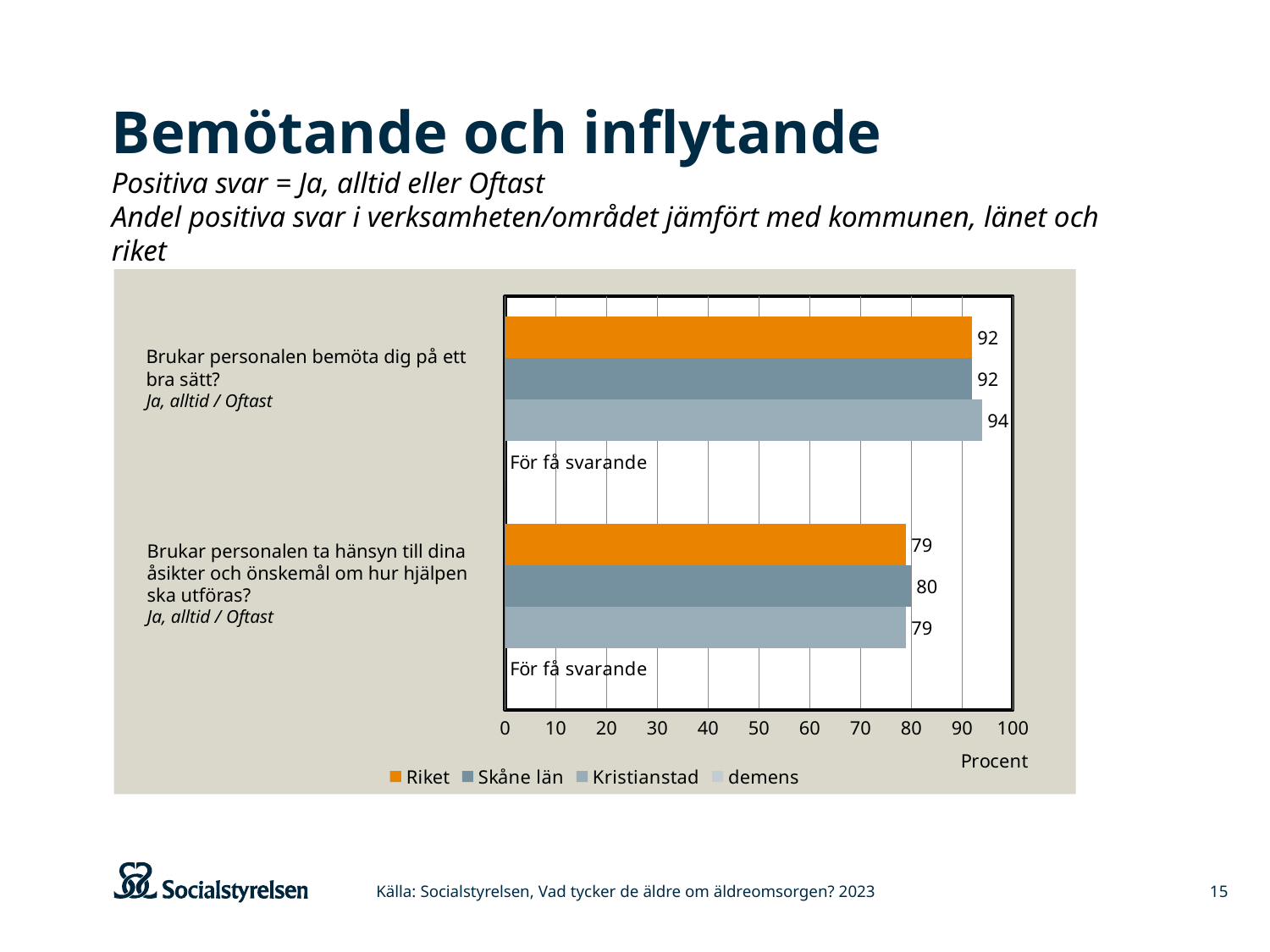
How many series does the legend list? 4 What is shown for the demens series instead of a bar? För få svarande Is the Skåne län value for "Brukar personalen ta hänsyn till dina åsikter och önskemål om hur hjälpen ska utföras?" greater or less than 90? less What is the value for Riket for the question "Brukar personalen bemöta dig på ett bra sätt?"? 92 What is the difference between the Kristianstad value and the Riket value for the question "Brukar personalen bemöta dig på ett bra sätt?"? 2 What is the value for Riket for the question "Brukar personalen ta hänsyn till dina åsikter och önskemål om hur hjälpen ska utföras?"? 79 What kind of chart is shown on the slide? Bar chart What unit is labelled on the x axis? Procent What is the difference between the Riket value for "Brukar personalen bemöta dig på ett bra sätt?" and the Riket value for "Brukar personalen ta hänsyn till dina åsikter och önskemål om hur hjälpen ska utföras?"? 13 Which series has the highest value for the question "Brukar personalen bemöta dig på ett bra sätt?"? Kristianstad What is the value for Skåne län for the question "Brukar personalen ta hänsyn till dina åsikter och önskemål om hur hjälpen ska utföras?"? 80 What is the value for Kristianstad for the question "Brukar personalen bemöta dig på ett bra sätt?"? 94